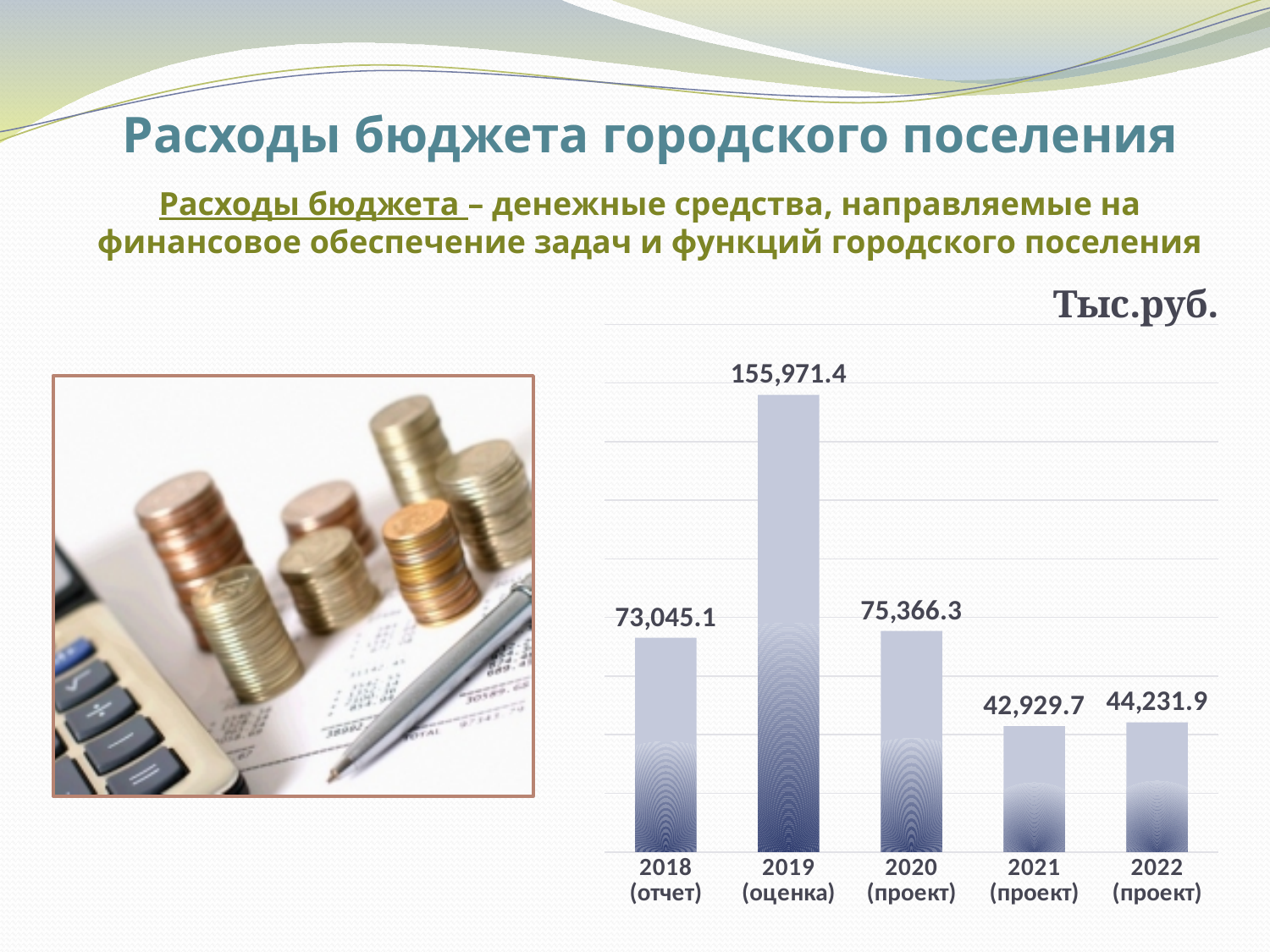
What kind of chart is shown on the slide? Bar chart What is the difference between the values for 2022 (проект) and 2021 (проект)? 1,302.2 What is the value for 2021 (проект)? 42,929.7 Which is larger, the value for 2018 (отчет) or 2020 (проект)? 2020 (проект) In what units are the chart values given? Тыс.руб. What is the value for 2018 (отчет)? 73,045.1 What is the value for 2022 (проект)? 44,231.9 What is the difference between the values for 2019 (оценка) and 2018 (отчет)? 82,926.3 What is the value for 2019 (оценка)? 155,971.4 Which year has the highest value? 2019 (оценка) How many years are shown on the chart? 5 Which year has the lowest value? 2021 (проект)